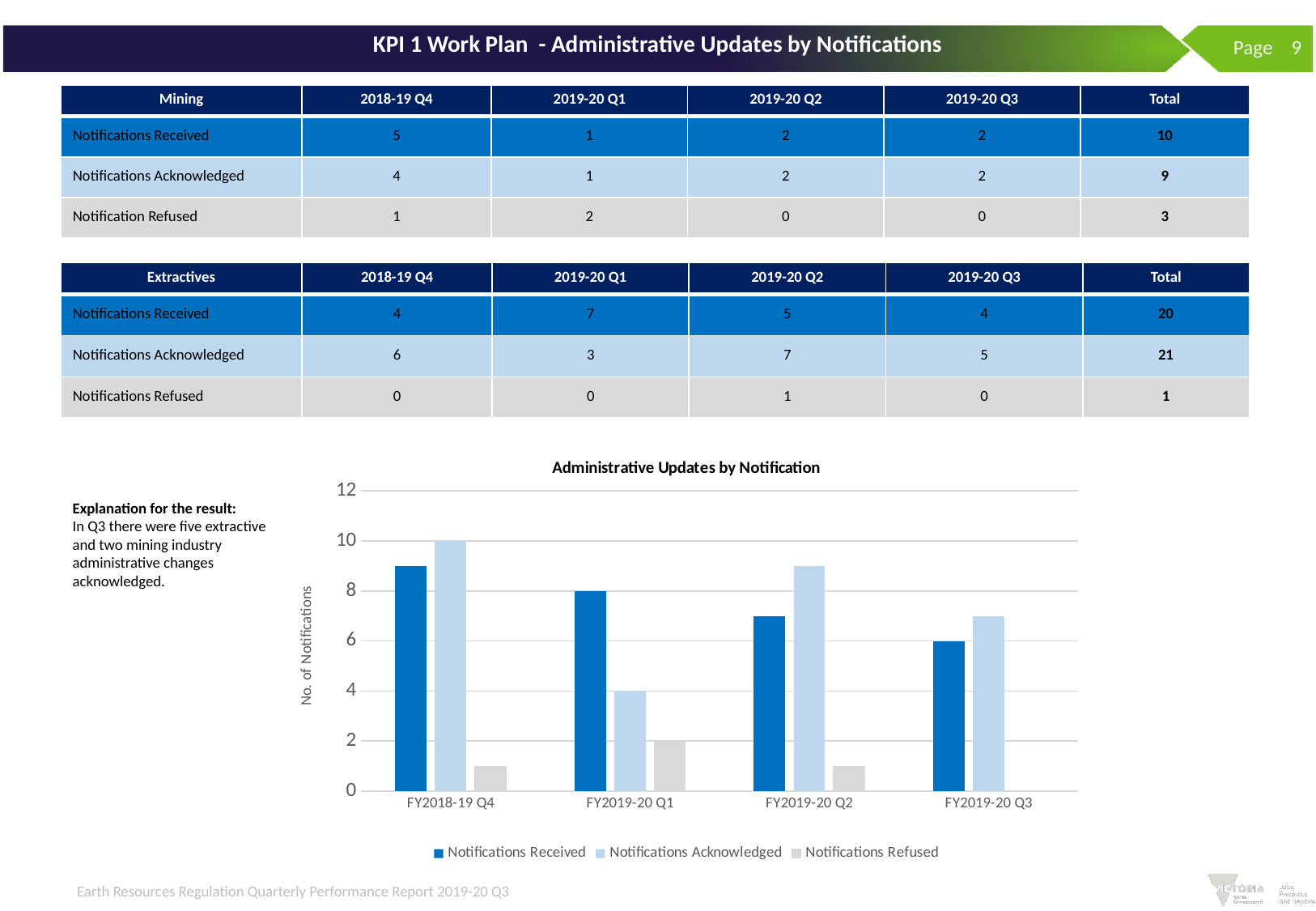
What is the value of Notifications Refused for FY2019-20 Q1 in the chart? 2 Do the Notifications Received values rise or fall from FY2018-19 Q4 to FY2019-20 Q3? Fall How many quarters are shown along the x axis of the chart? 4 What is the value of Notifications Received for FY2019-20 Q1 in the chart? 8 What is the value of Notifications Acknowledged for FY2018-19 Q4 in the chart? 10 How many series does the chart legend list? 3 Is the value of Notifications Acknowledged for FY2019-20 Q2 greater or less than 8? greater In FY2019-20 Q1, which is larger: Notifications Received or Notifications Acknowledged? Notifications Received What kind of chart is shown on the slide? Bar chart In which quarter is Notifications Acknowledged highest in the chart? FY2018-19 Q4 What is the difference between Notifications Received and Notifications Acknowledged in FY2019-20 Q1? 4 What is the value of Notifications Received for FY2019-20 Q3 in the chart? 6